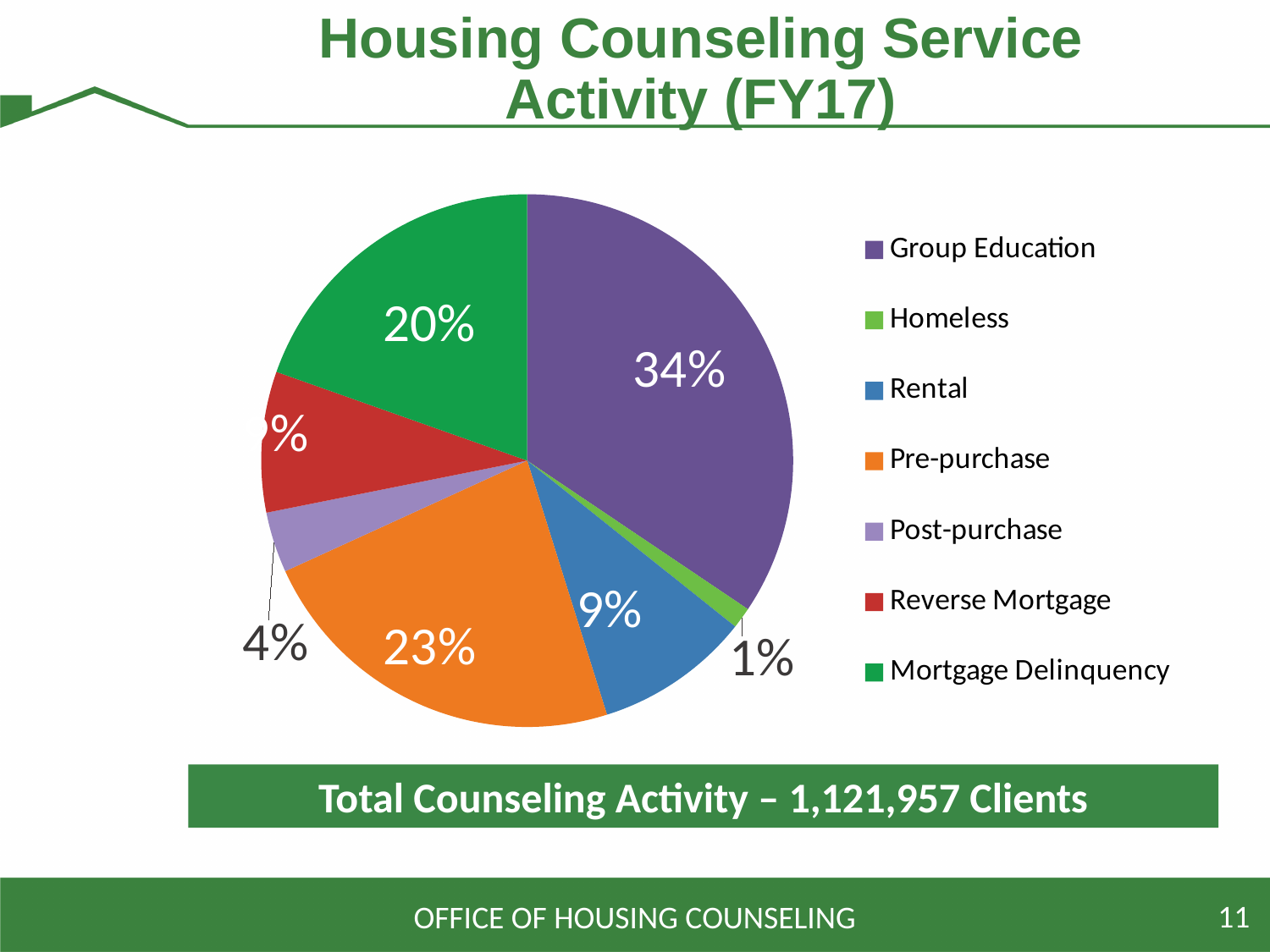
What type of chart is shown on the slide? Pie chart How many percentage points larger is Group Education than Pre-purchase? 11 percentage points Which is larger, the Rental slice or the Mortgage Delinquency slice? Mortgage Delinquency Which category has the largest slice of the pie? Group Education What percentage is shown for Pre-purchase? 23% What share of the pie is Post-purchase? 4% How many categories does the pie chart show? 7 What colour is used for the Pre-purchase slice? Orange What share does Mortgage Delinquency account for? 20% What percentage is labelled for Rental? 9% What share of the pie does Group Education represent? 34% Which category has the smallest slice of the pie? Homeless